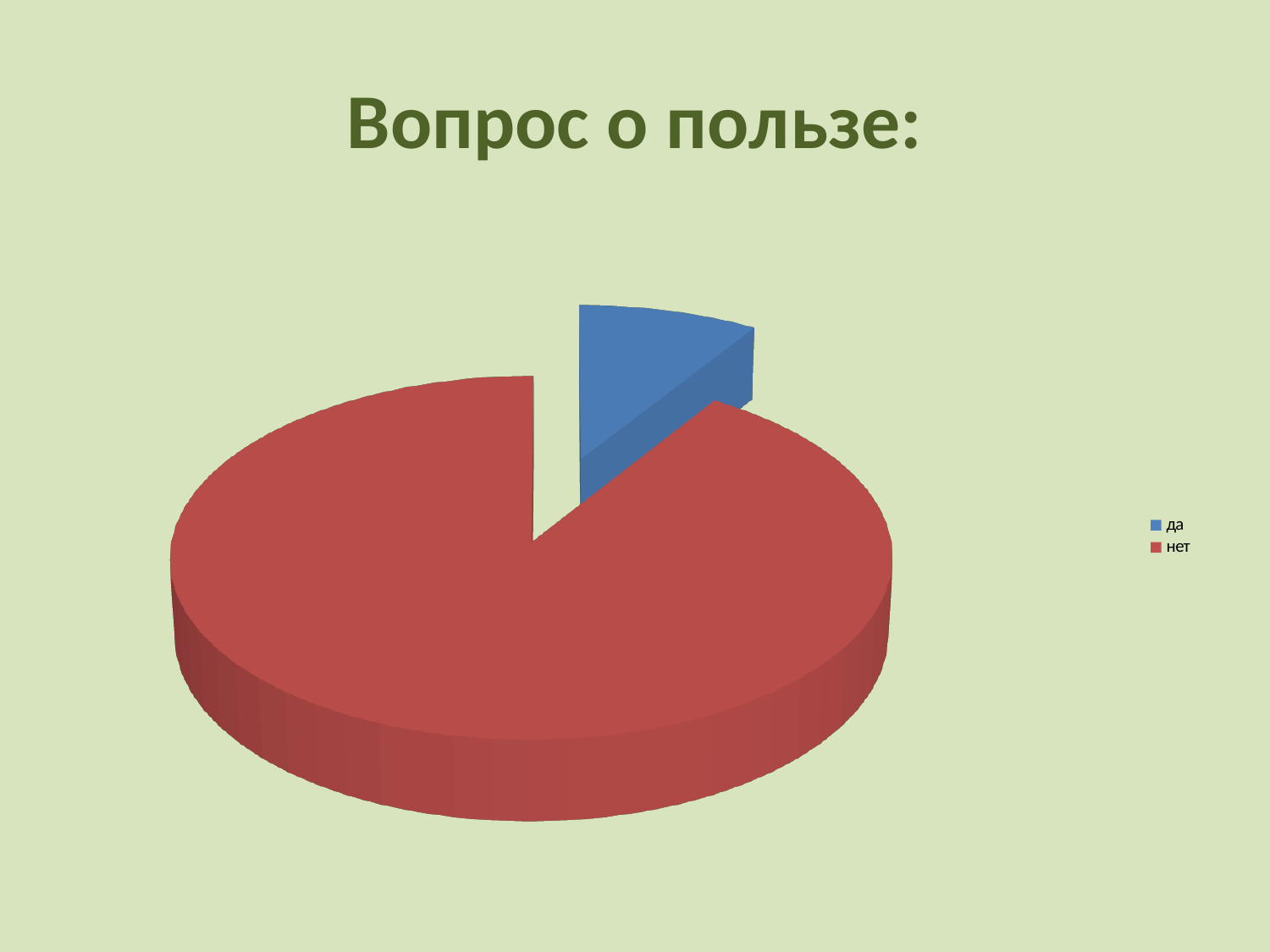
What colour is the slice for нет? red Which category has the smallest slice of the pie? да How many entries does the legend list? 2 Which slice is larger, да or нет? нет What is the title of the slide above the chart? Вопрос о пользе: How many slices does the pie chart have? 2 What kind of chart is shown on the slide? pie chart Which category has the largest slice of the pie? нет